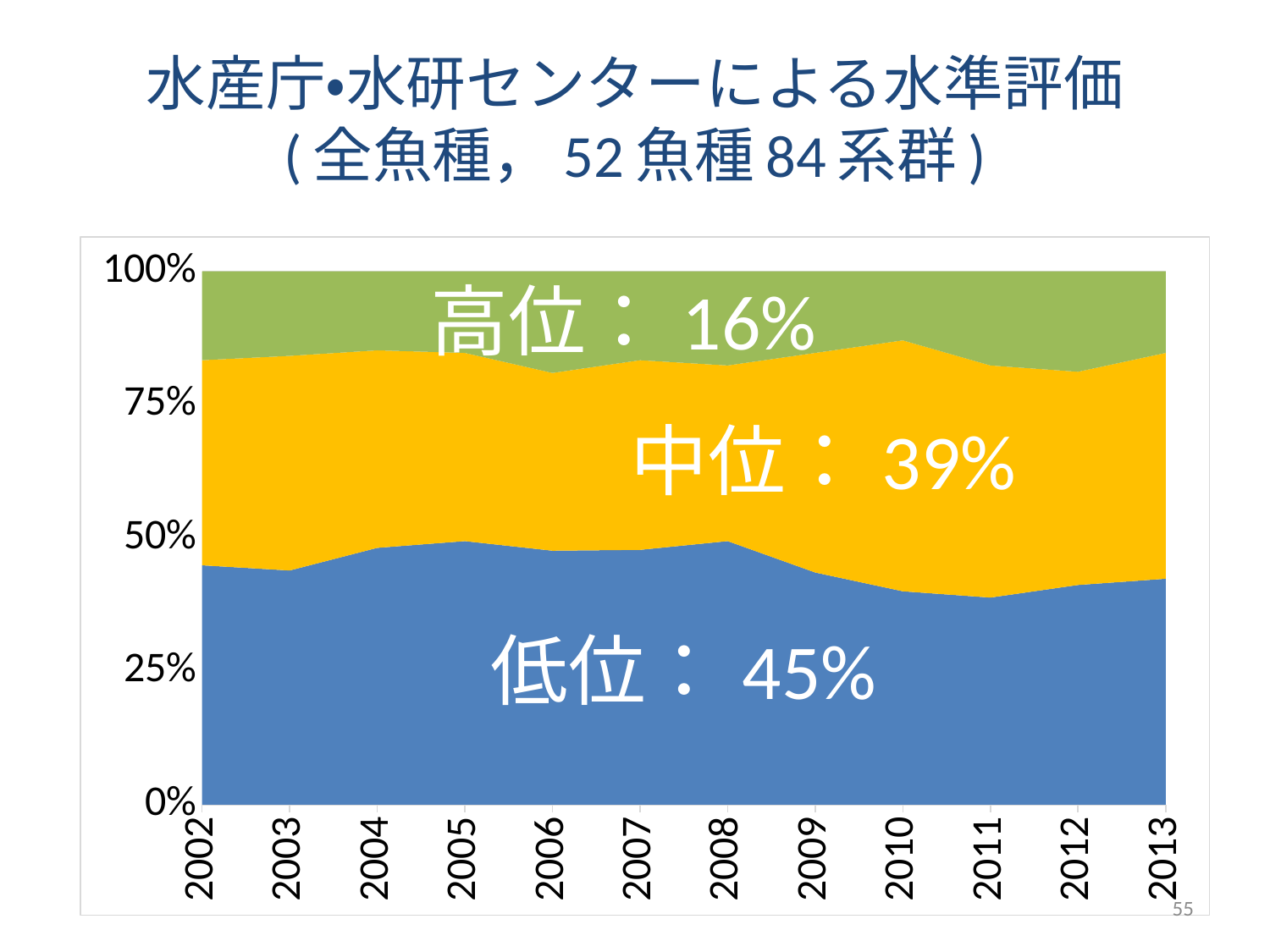
How many years are shown on the x axis? 12 What kind of chart is shown on the slide? stacked area chart Which has a larger printed percentage, 中位 or 高位? 中位 What percentage is printed for 高位 on the chart? 16% How many series (categories) are stacked in the chart? 3 Does the share of 低位 rise or fall from 2008 to 2011? fall Which of the three categories has the largest printed percentage? 低位 What percentage is printed for 中位 on the chart? 39% What percentage is printed for 低位 on the chart? 45% Which of the three categories has the smallest printed percentage? 高位 Is the share of 低位 in 2011 greater or less than 50%? less What is the difference between the printed percentages for 低位 and 高位? 29%